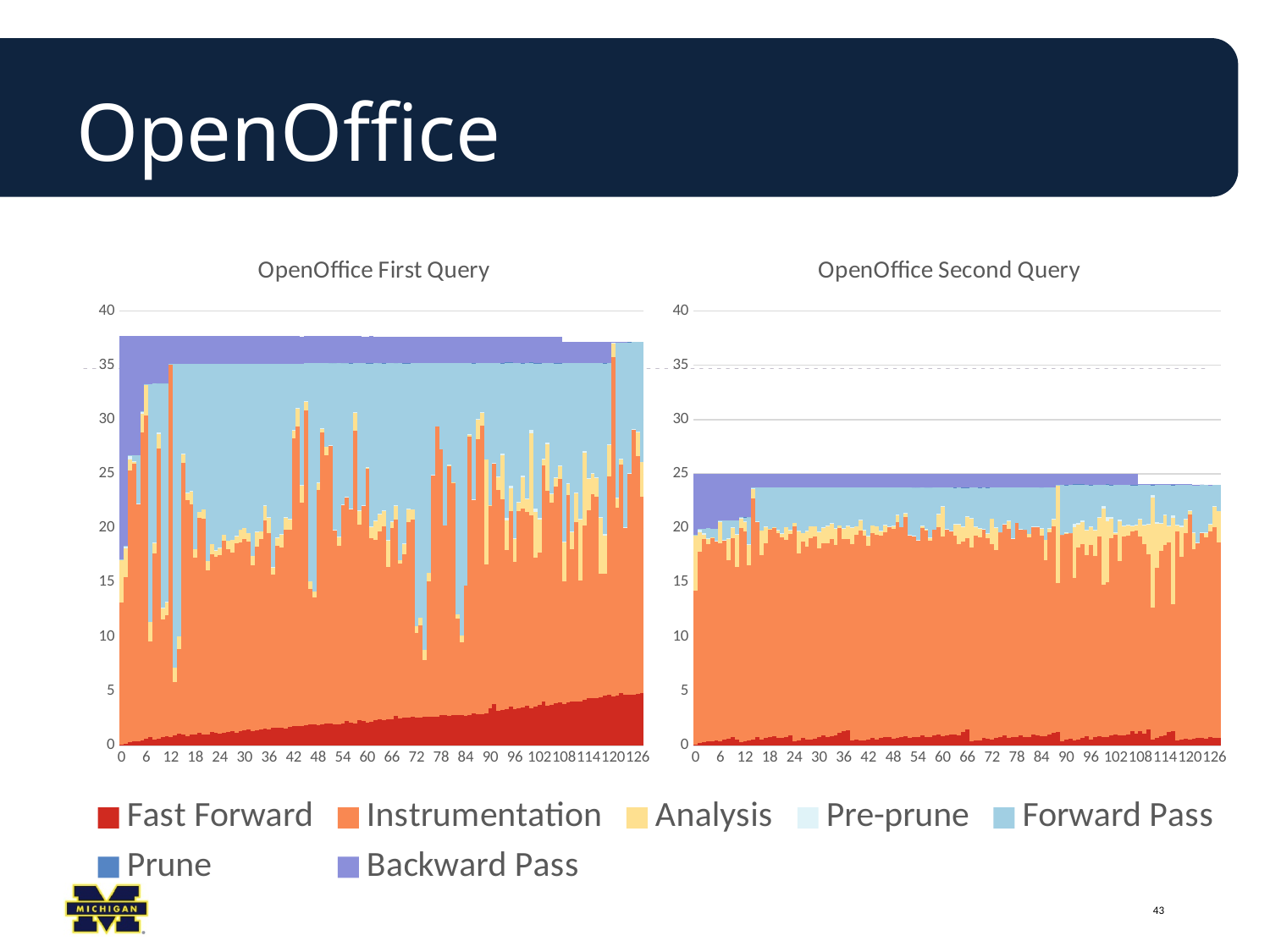
In the OpenOffice First Query chart, does the Fast Forward series rise or fall as x increases from 0 to 126? rise In the OpenOffice Second Query chart, is the Fast Forward value at x = 60 greater or less than 5? less In the OpenOffice First Query chart, is the total stacked height at x = 30 greater or less than 35? greater What is the title of the chart on the left? OpenOffice First Query Which chart has the larger total stacked height at x = 60, OpenOffice First Query or OpenOffice Second Query? OpenOffice First Query In the OpenOffice Second Query chart, is the total stacked height at x = 6 greater or less than 20? greater What is the highest value labelled on the y axis of the OpenOffice Second Query chart? 40 What kind of chart is the OpenOffice First Query chart? Stacked bar chart How many series does the legend list for the charts? 7 Which series is shown in red in the legend? Fast Forward